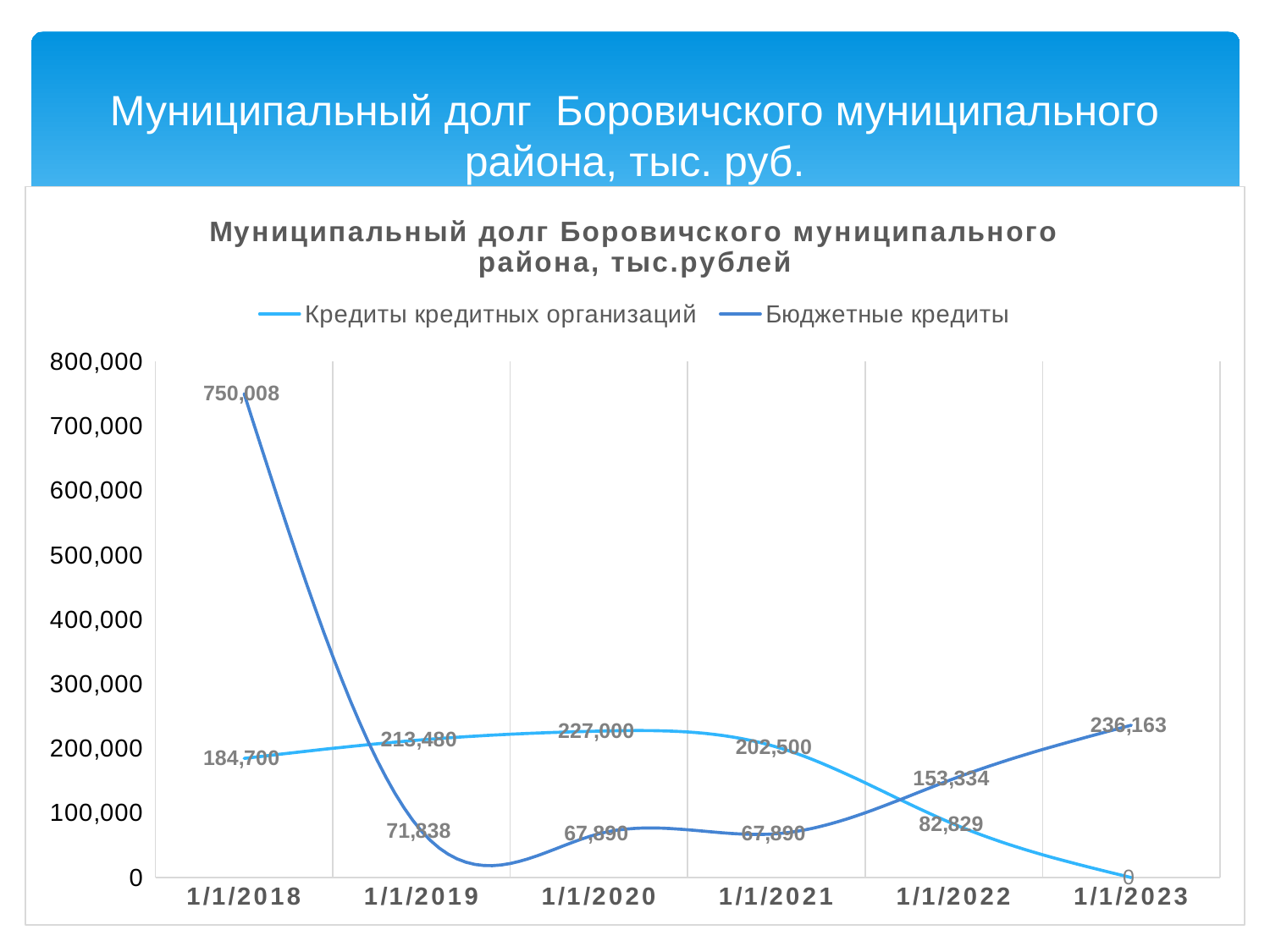
What is the value of Бюджетные кредиты on 1/1/2018? 750,008 What is the value of Кредиты кредитных организаций on 1/1/2023? 0 What is the difference between Бюджетные кредиты on 1/1/2023 and on 1/1/2022? 82,829 On which date is Бюджетные кредиты at its highest? 1/1/2018 What is the value of Кредиты кредитных организаций on 1/1/2020? 227,000 What type of chart is shown on the slide? line chart Which series has the larger value on 1/1/2021, Кредиты кредитных организаций or Бюджетные кредиты? Кредиты кредитных организаций What is the value of Бюджетные кредиты on 1/1/2023? 236,163 How many series does the chart legend list? 2 How many dates are shown on the x axis of the chart? 6 On which date is Кредиты кредитных организаций at its lowest? 1/1/2023 Does Кредиты кредитных организаций rise or fall from 1/1/2020 to 1/1/2023? fall